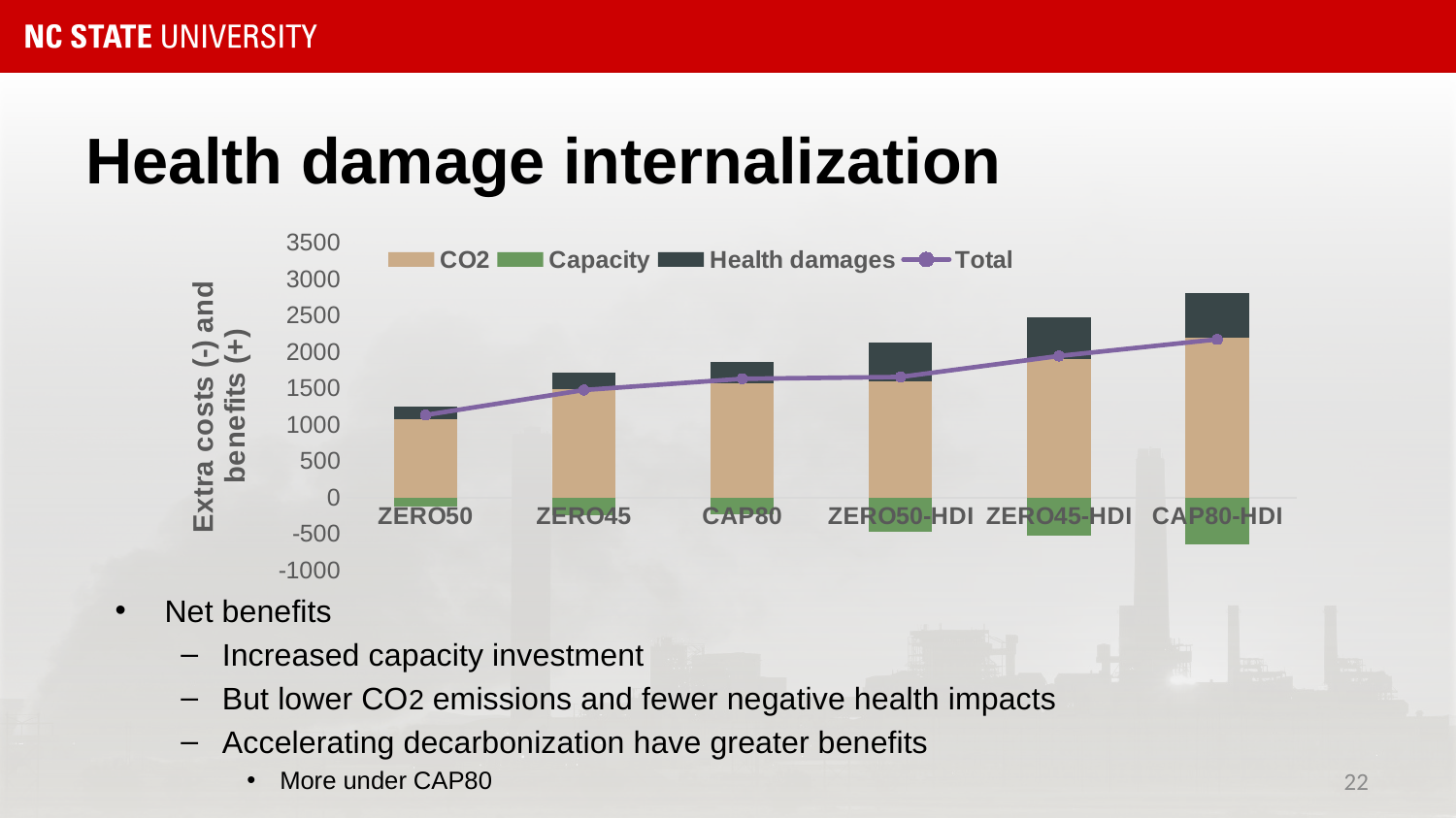
Is the Capacity value for ZERO50 greater or less than -500? greater Which category has the highest Total value? CAP80-HDI Is the Total value for CAP80-HDI greater or less than 2000? greater How many categories are shown on the x axis of the chart? 6 What kind of chart is shown on the slide? Stacked bar chart with a line What is the y-axis title of the chart? Extra costs (-) and benefits (+) Is the Total value for ZERO50 greater or less than 1500? less How many series does the chart's legend list? 4 Which has the larger Total value, ZERO45-HDI or ZERO50? ZERO45-HDI Does the Total line rise or fall from ZERO50 to CAP80-HDI? Rise Which category has the lowest Total value? ZERO50 Which series are listed in the chart's legend? CO2, Capacity, Health damages, Total